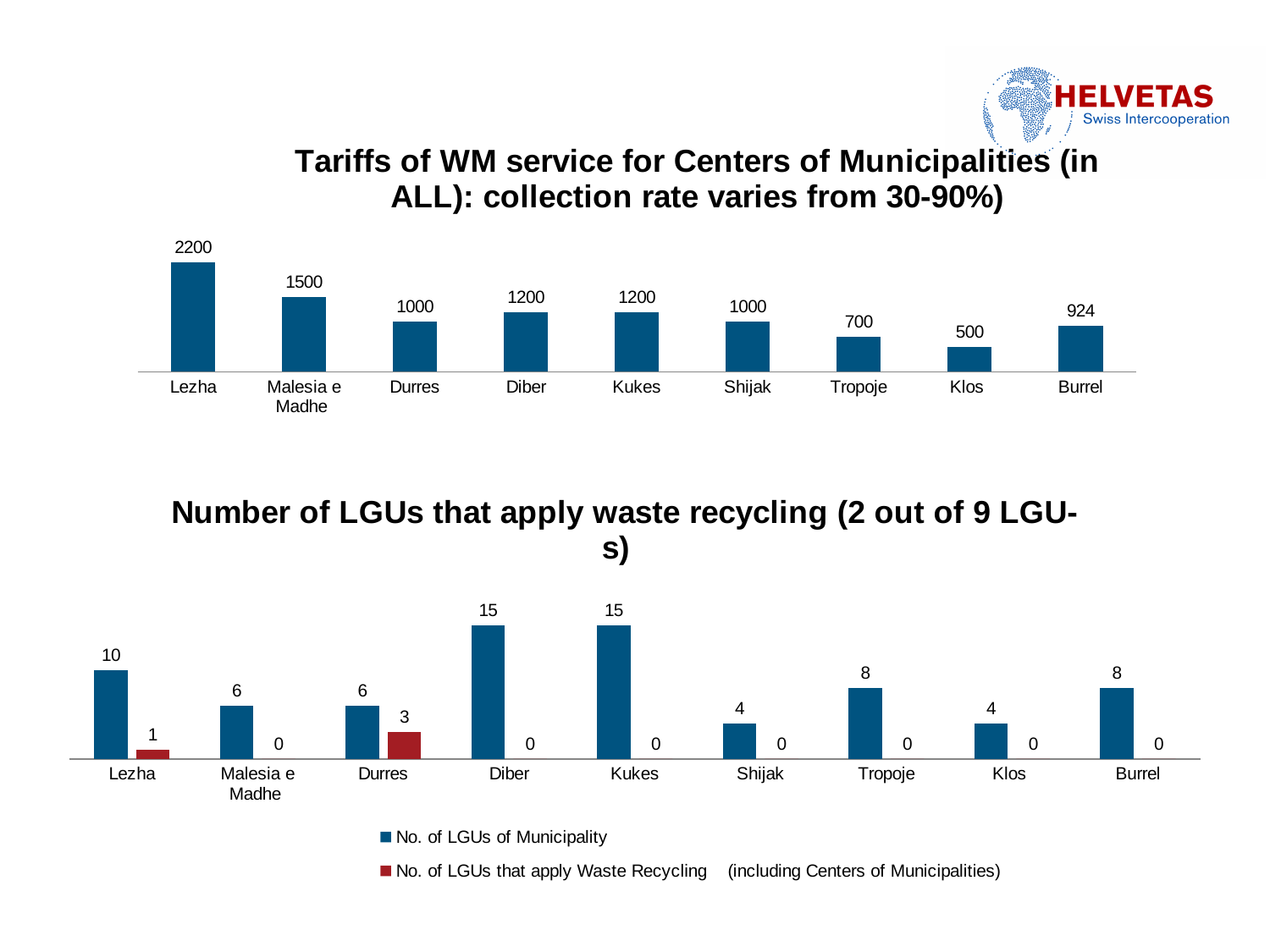
In the top chart (Tariffs of WM service), how many municipalities are shown? 9 In the bottom chart (Number of LGUs that apply waste recycling), what is the difference between the number of LGUs of Municipality in Lezha and the number that apply waste recycling there? 9 In the bottom chart (Number of LGUs that apply waste recycling), what colour are the bars for LGUs that apply waste recycling? Red In the bottom chart (Number of LGUs that apply waste recycling), how many LGUs of Municipality does Diber have? 15 In the bottom chart (Number of LGUs that apply waste recycling), how many series does the legend list? 2 In the bottom chart (Number of LGUs that apply waste recycling), how many LGUs in Durres apply waste recycling? 3 In the top chart (Tariffs of WM service), which is larger, the tariff for Tropoje or for Burrel? Burrel In the top chart (Tariffs of WM service), what is the tariff for Lezha? 2200 In the top chart (Tariffs of WM service), which municipality has the lowest tariff? Klos In the top chart (Tariffs of WM service), what is the difference between the tariffs of Malesia e Madhe and Burrel? 576 In the top chart (Tariffs of WM service), what is the tariff for Diber? 1200 What type of chart is the bottom chart (Number of LGUs that apply waste recycling)? Bar chart